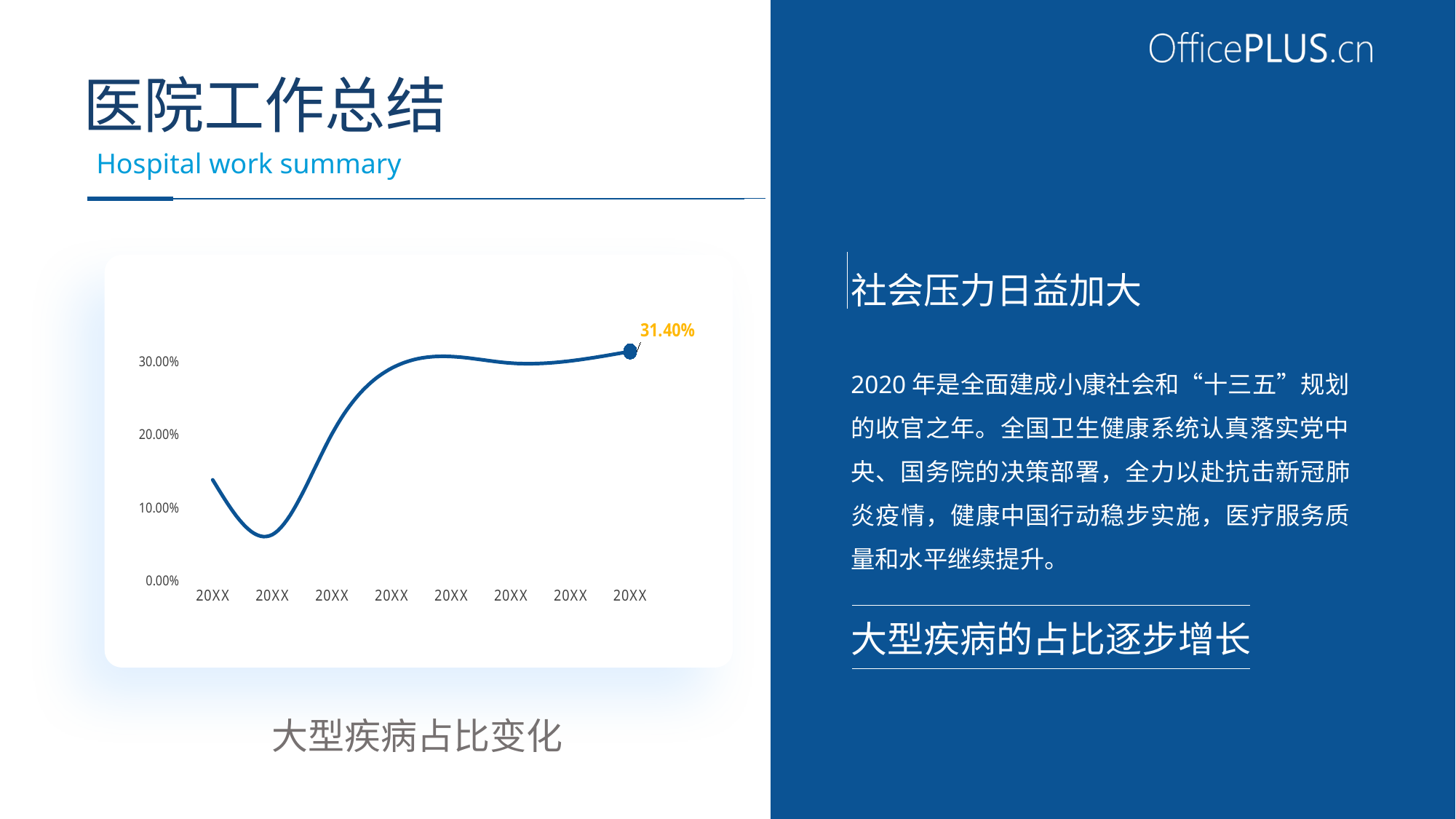
Which point on the line chart has the highest value? the last (rightmost) point How many data points are plotted on the line chart? 8 Is the value for the first point or the last point on the line chart larger? the last point Is the value for the last point on the line chart greater or less than 30.00%? greater What is the caption shown below the line chart? 大型疾病占比变化 Which point on the line chart has the lowest value? the second point What kind of chart is shown on the slide? line chart Overall, do the values on the line chart rise or fall from the first point to the last point? rise What is the highest value shown on the y-axis of the line chart? 30.00% Is the value for the first point on the line chart greater or less than 20.00%? less Is the value for the second point on the line chart greater or less than 10.00%? less What value is labelled on the last (rightmost) point of the line chart? 31.40%